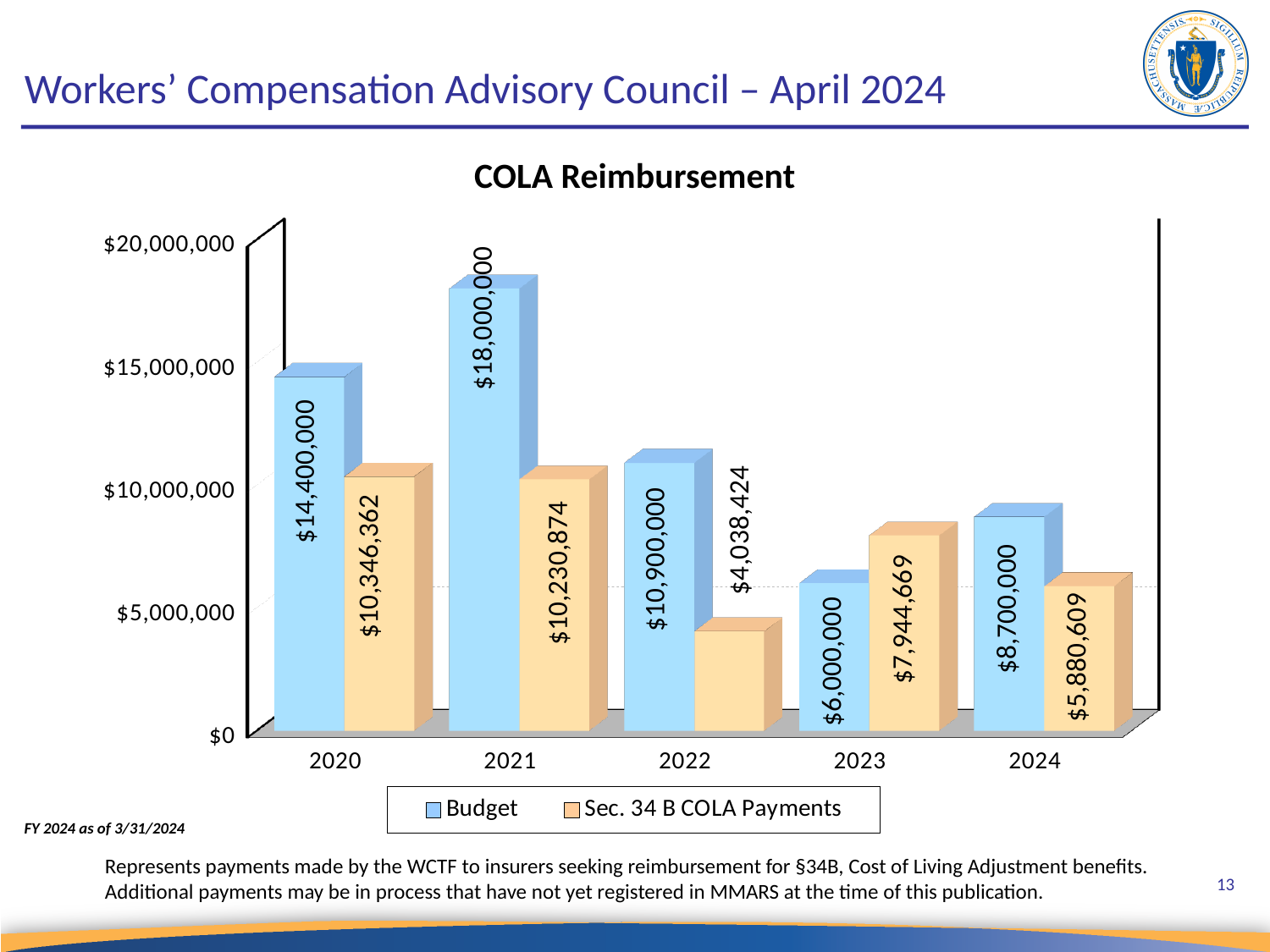
How many years are shown on the x axis? 5 Which year has the lowest Sec. 34 B COLA Payments value? 2022 How many series does the legend list? 2 What is the difference between the Budget and the Sec. 34 B COLA Payments in 2020? $4,053,638 Does the Budget value rise or fall from 2021 to 2023? Fall What is the Budget value for 2021? $18,000,000 Which year has the highest Budget value? 2021 What is the title of the chart? COLA Reimbursement In 2023, which is larger: the Budget or the Sec. 34 B COLA Payments? Sec. 34 B COLA Payments What is the Budget value for 2024? $8,700,000 What kind of chart is shown? Bar chart What is the Sec. 34 B COLA Payments value for 2022? $4,038,424